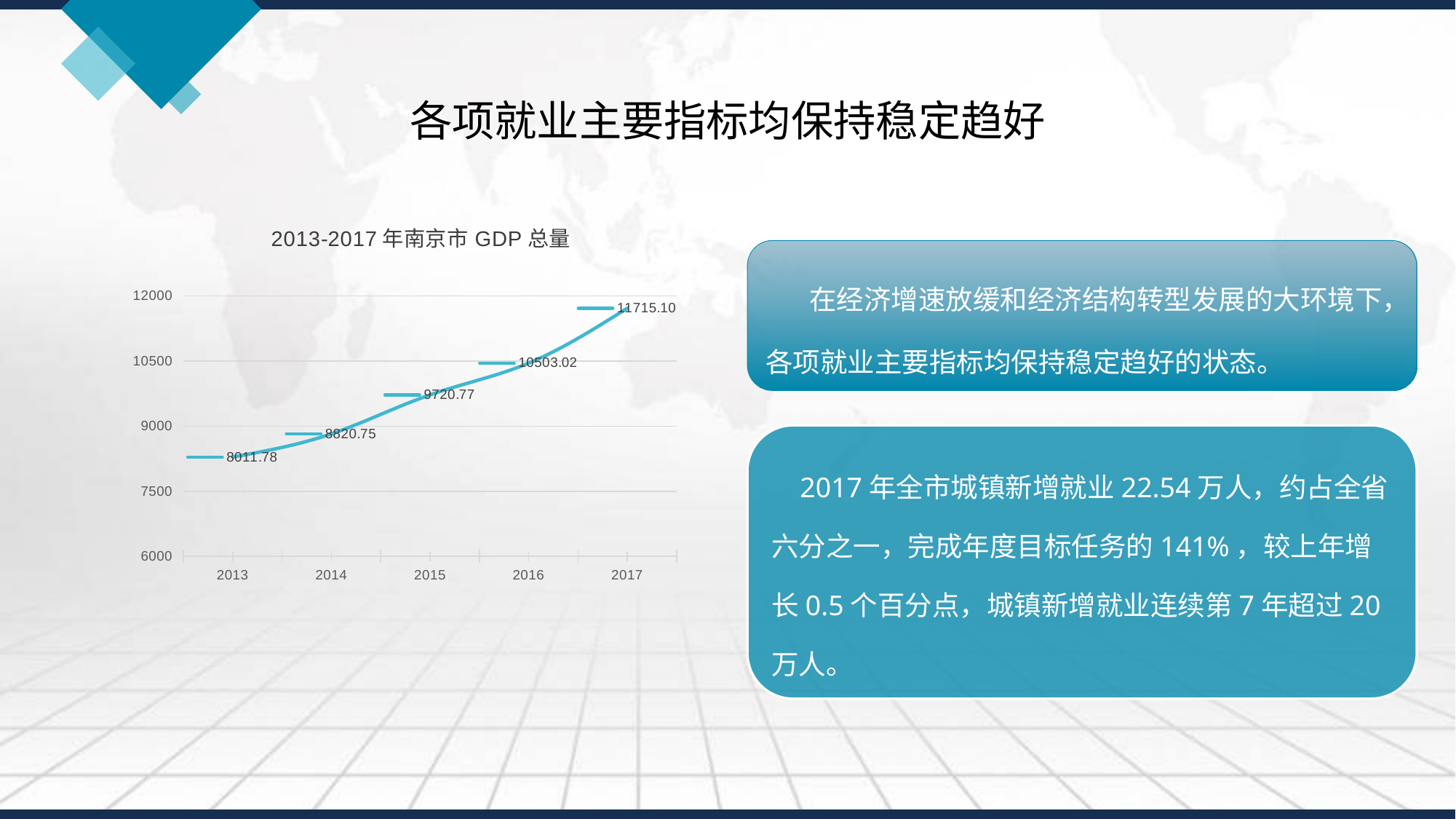
What is the GDP value shown for 2017? 11715.10 Which year has the lowest GDP value in the chart? 2013 What is the GDP value shown for 2015? 9720.77 Which year has the highest GDP value in the chart? 2017 What is the difference between the GDP values for 2017 and 2016? 1212.08 Which is larger, the GDP value for 2016 or for 2015? 2016 What is the GDP value shown for 2013? 8011.78 How many years are plotted in the chart? 5 What is the difference between the GDP values for 2014 and 2013? 808.97 Do the GDP values rise or fall from 2013 to 2017? rise What kind of chart is shown on the slide? line chart